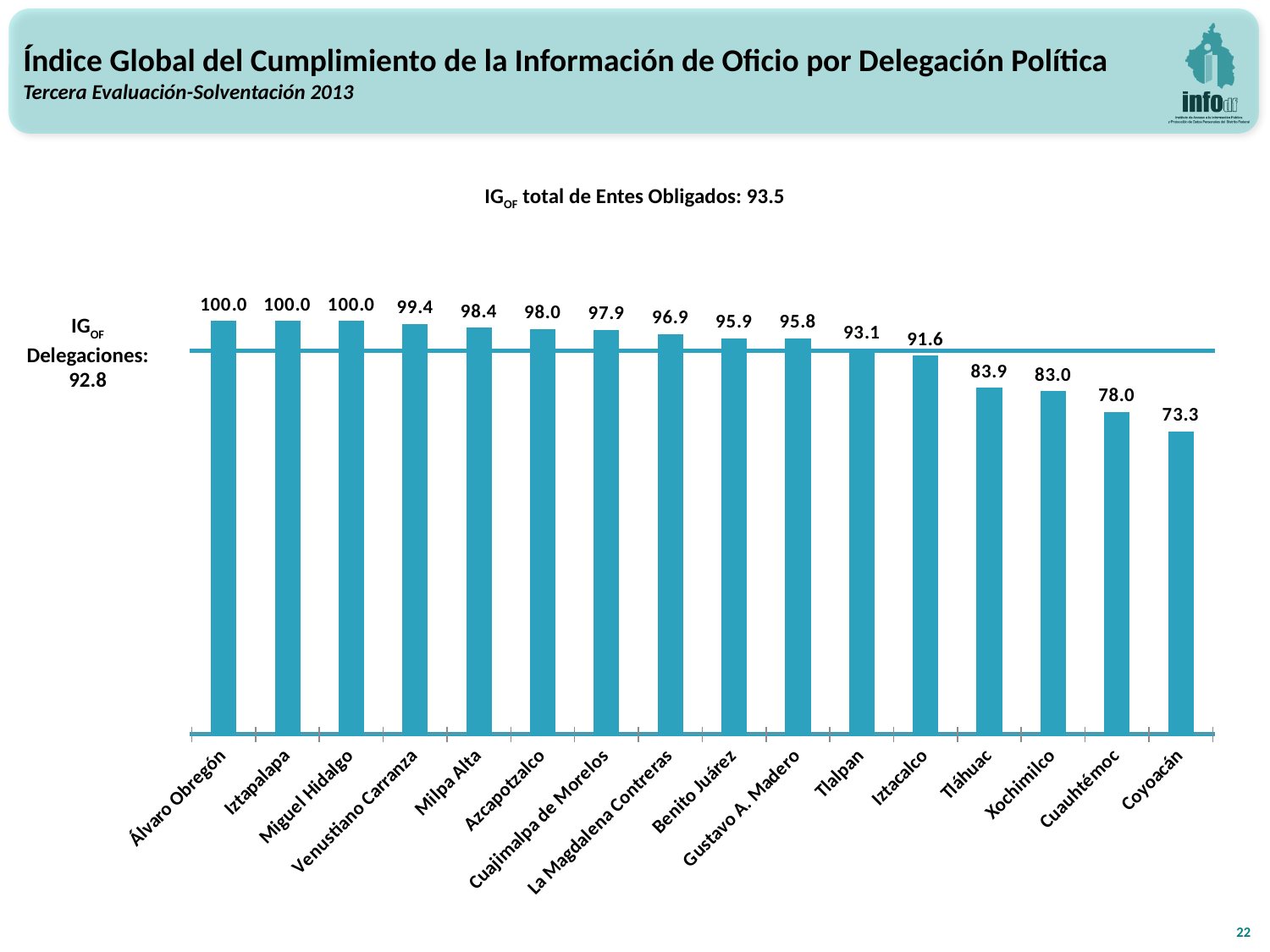
Which is larger, the value for Benito Juárez or the value for Iztacalco? Benito Juárez What is the value for Tlalpan? 93.1 What is the difference between the values for Iztacalco and Tláhuac? 7.7 What is the difference between the values for Milpa Alta and Cuauhtémoc? 20.4 Which delegación has the lowest value? Coyoacán Do the values rise or fall from left to right along the x axis? Fall How many delegaciones are shown on the x axis? 16 What value does the horizontal reference line labelled IGOF Delegaciones represent? 92.8 What is the value for Venustiano Carranza? 99.4 What kind of chart is shown on the slide? Bar chart What is the value for Xochimilco? 83.0 How many delegaciones have a value of 100.0? 3